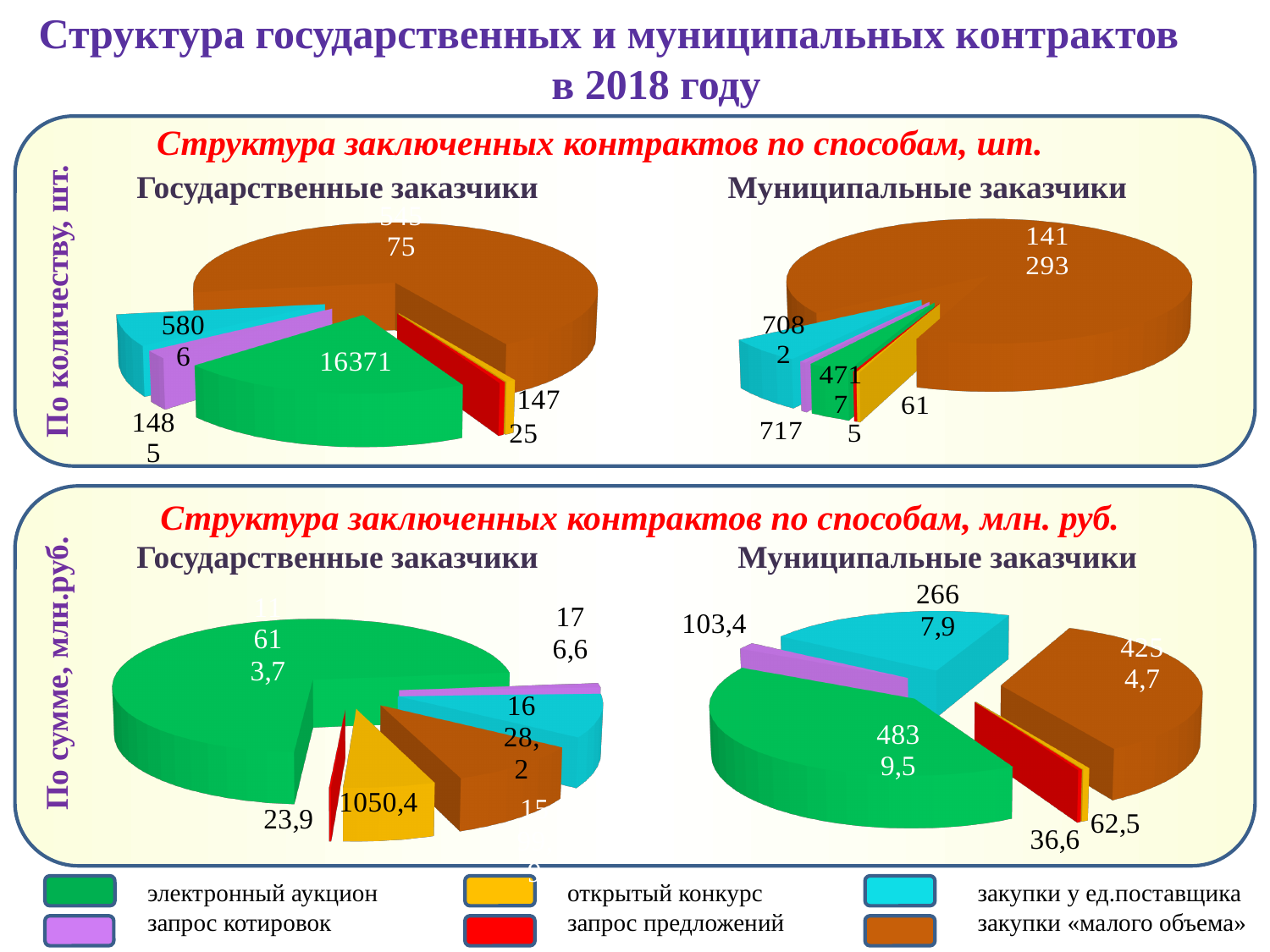
In the bottom-right pie chart (Муниципальные заказчики, млн. руб.), what is the difference between the yellow slice (62,5) and the red slice (36,6)? 25,9 In the bottom-right pie chart (Муниципальные заказчики, млн. руб.), what is the value of the purple slice (запрос котировок)? 203,4 What kind of charts are shown on the slide? Pie charts In the top-right pie chart (Муниципальные заказчики, шт.), which is larger: the yellow slice (открытый конкурс) or the red slice (запрос предложений)? открытый конкурс In the bottom-left pie chart (Государственные заказчики, млн. руб.), what is the value of the yellow slice (открытый конкурс)? 1050,4 In the bottom-left pie chart (Государственные заказчики, млн. руб.), which category has the largest slice? электронный аукцион In the top-right pie chart (Муниципальные заказчики, шт.), what is the value of the purple slice (запрос котировок)? 717 In the top-left pie chart (Государственные заказчики, шт.), what is the value of the green slice (электронный аукцион)? 16371 In the top-right pie chart (Муниципальные заказчики, шт.), which category has the largest slice? закупки «малого объема» How many categories does the legend at the bottom of the slide list? 6